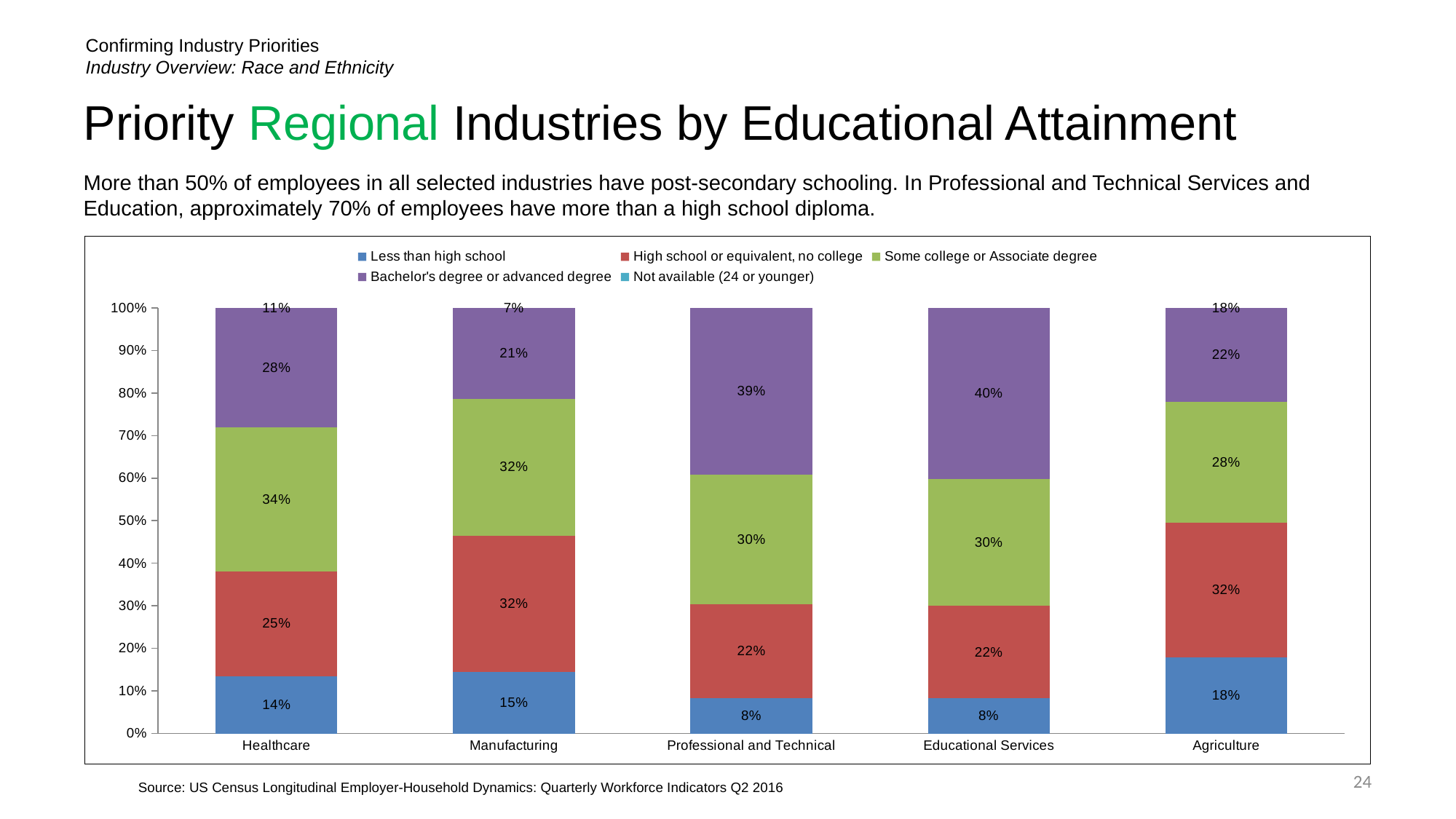
How many industries are shown on the x axis of the chart? 5 Which series in the legend is shown in green? Some college or Associate degree What is the difference between the 'Bachelor's degree or advanced degree' share for Professional and Technical and for Manufacturing? 18% What is the 'Less than high school' share for Healthcare? 14% How many series does the chart legend list? 5 Which is larger: the 'High school or equivalent, no college' share for Healthcare or for Agriculture? Agriculture Which industry has the highest 'Bachelor's degree or advanced degree' share? Educational Services Which industry has the highest 'Less than high school' share? Agriculture What is the 'High school or equivalent, no college' share for Manufacturing? 32% What type of chart is shown on the slide? stacked bar chart What is the 'Some college or Associate degree' share for Agriculture? 28% What is the 'Bachelor's degree or advanced degree' share for Educational Services? 40%